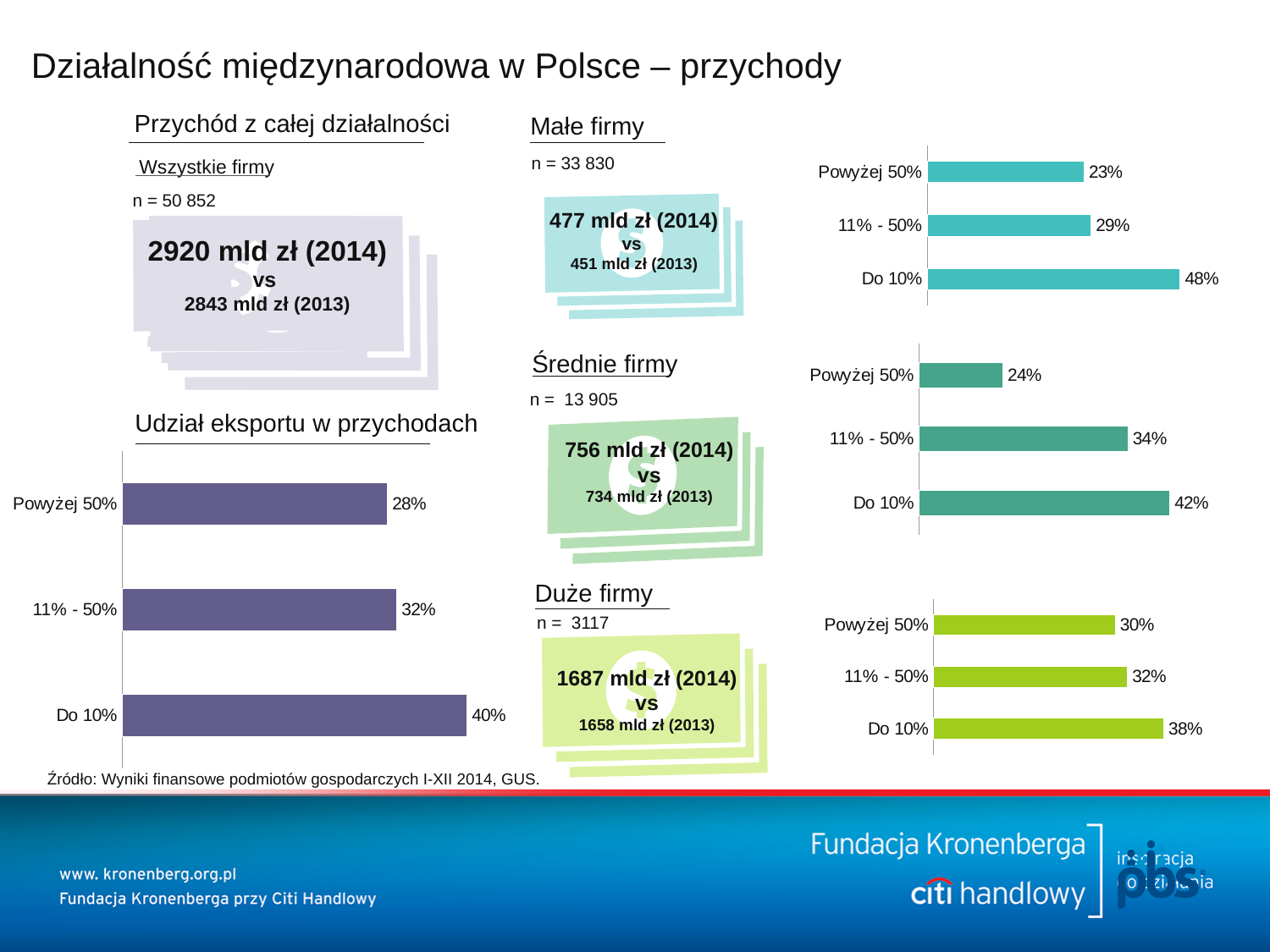
How many categories does the 'Duże firmy' chart show? 3 In the 'Duże firmy' chart, what is the difference between 'Do 10%' and 'Powyżej 50%'? 8% In the 'Udział eksportu w przychodach' chart on the left, what is the difference between 'Do 10%' and 'Powyżej 50%'? 12% In the 'Małe firmy' chart, what is the value for 'Powyżej 50%'? 23% In the 'Średnie firmy' chart, what is the value for '11% - 50%'? 34% What type of chart is the 'Udział eksportu w przychodach' chart on the left? Bar chart In the 'Średnie firmy' chart, which is larger, 'Powyżej 50%' or 'Do 10%'? Do 10% In the 'Udział eksportu w przychodach' chart on the left, what is the value for 'Do 10%'? 40% In the 'Duże firmy' chart, what is the value for 'Do 10%'? 38% In the 'Małe firmy' chart, what is the difference between 'Do 10%' and '11% - 50%'? 19% In the 'Udział eksportu w przychodach' chart on the left, which category has the lowest value? Powyżej 50% In the 'Małe firmy' chart, which category has the highest value? Do 10%